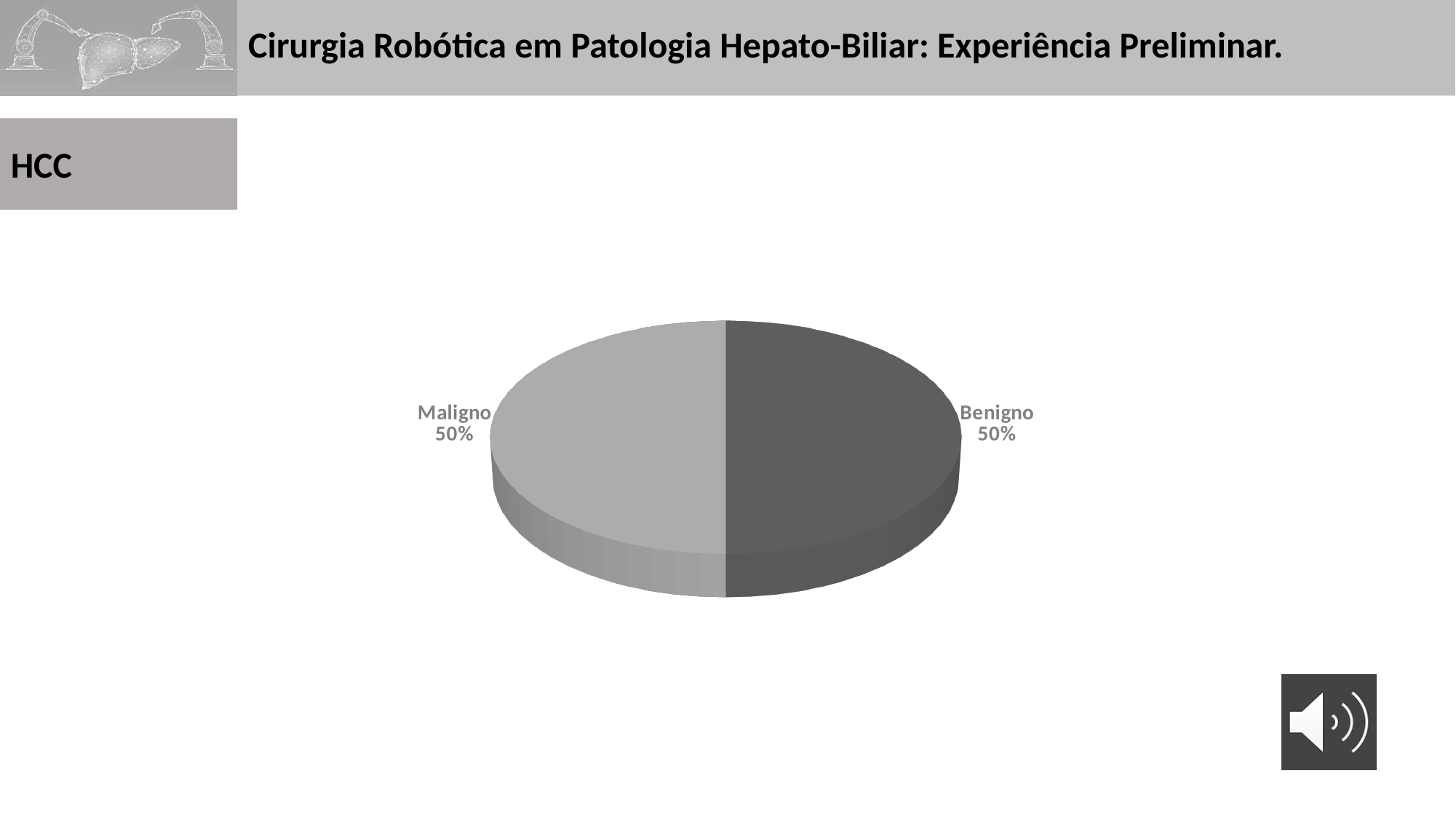
What share of the pie does the Benigno slice represent? 50% What is the difference between the Maligno and Benigno shares? 0% How many slices does the pie chart have? 2 Which slice is labelled on the left side of the pie chart? Maligno What kind of chart is shown on the slide? pie chart Which slice of the pie chart is drawn in the darker grey? Benigno What is the combined share of the Maligno and Benigno slices? 100% What share of the pie does the Maligno slice represent? 50%